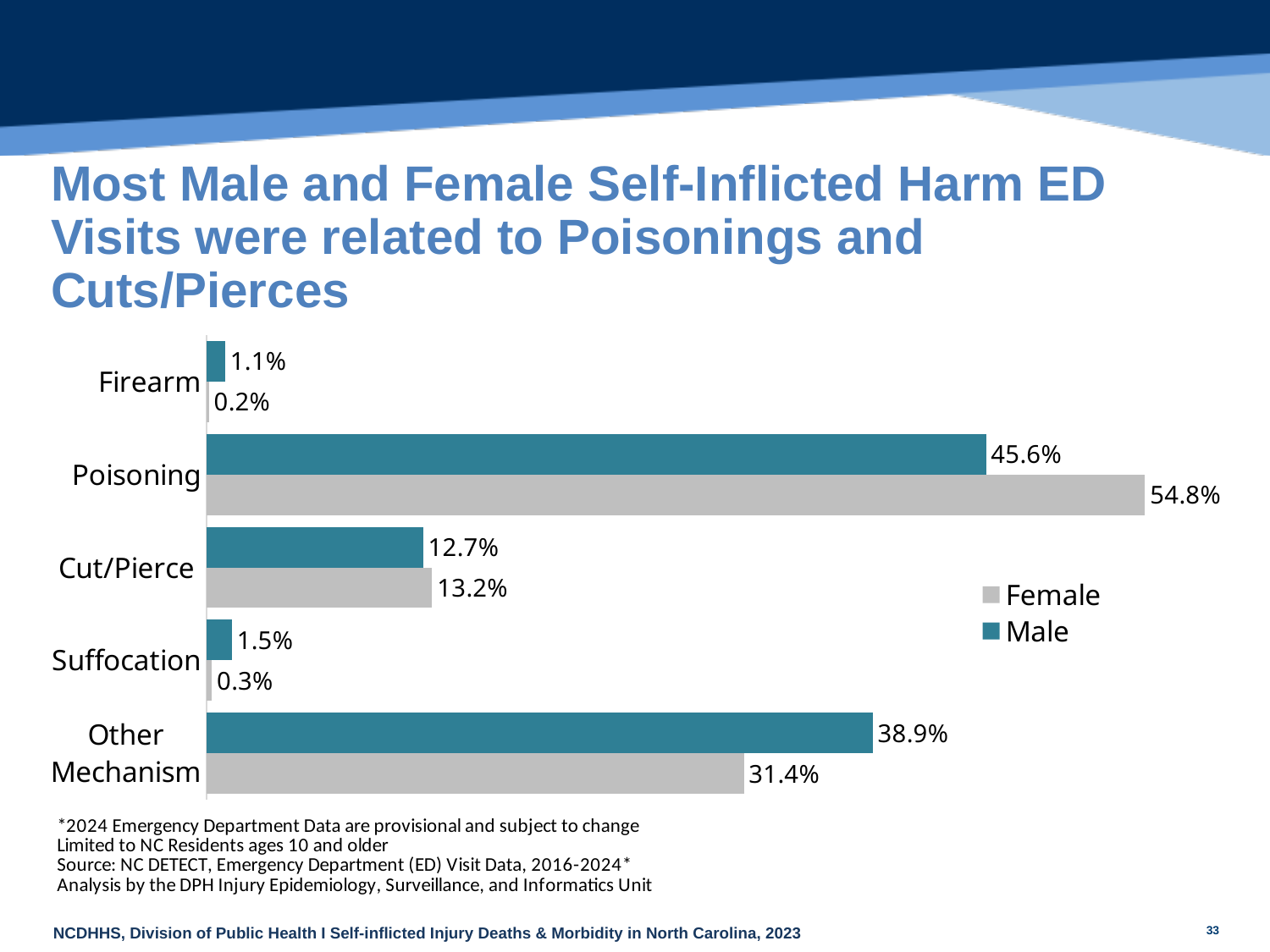
For Other Mechanism, which is larger, the Male value or the Female value? Male What is the Male value for Other Mechanism? 38.9% Which category has the lowest Male value? Firearm How many series does the legend list? 2 What is the Male value for Poisoning? 45.6% What is the difference between the Female and Male values for Poisoning? 9.2% What kind of chart is shown on the slide? Bar chart What is the Female value for Poisoning? 54.8% What is the Female value for Firearm? 0.2% What is the Female value for Cut/Pierce? 13.2% Which category has the highest Female value? Poisoning How many categories are shown on the chart? 5